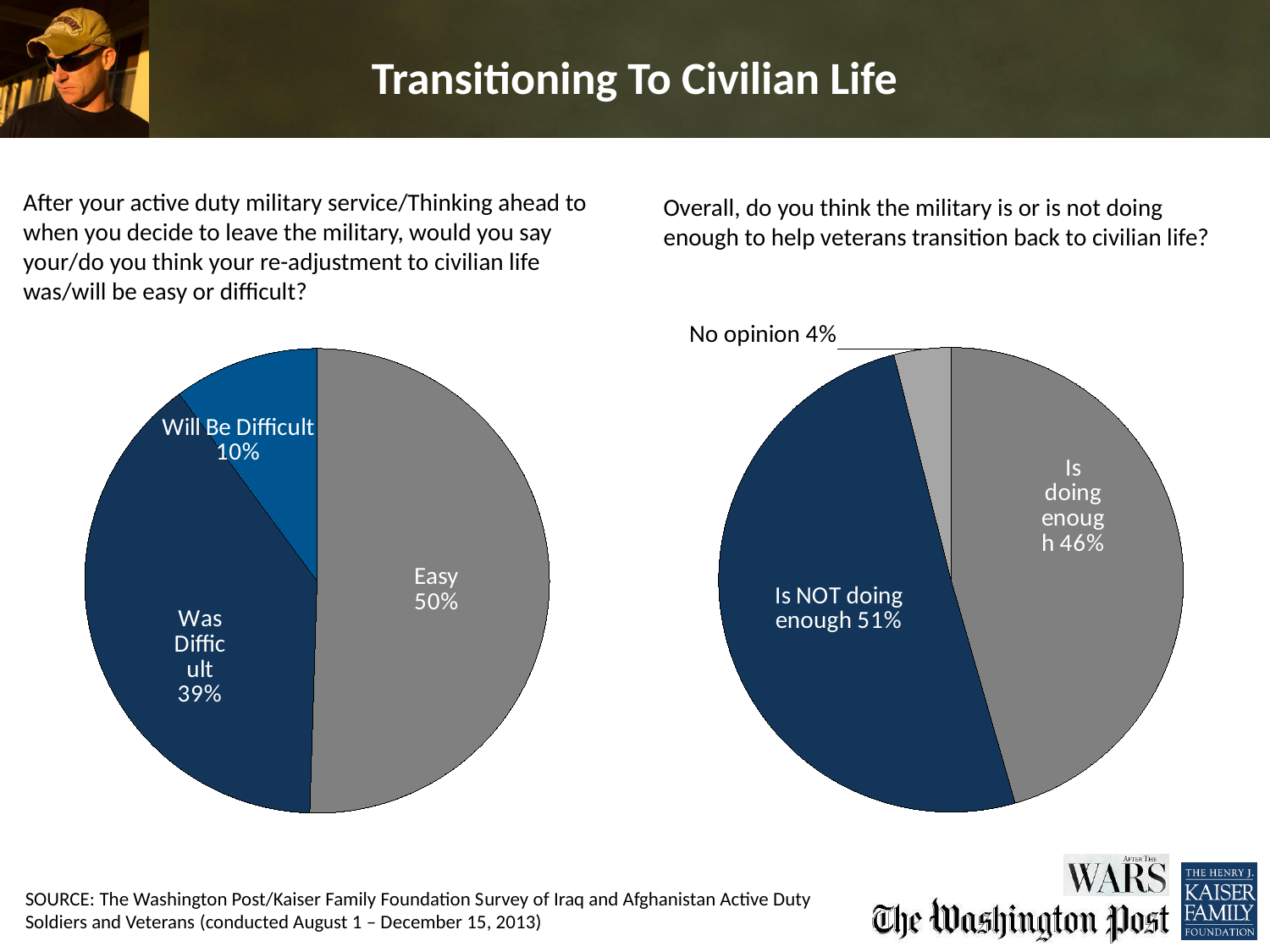
In the left pie chart, what share of respondents said their re-adjustment to civilian life was or will be easy? 50% How many slices does the left pie chart have? 3 In the right pie chart, which is larger: 'Is doing enough' or 'Is NOT doing enough'? Is NOT doing enough In the left pie chart, what percentage is shown for 'Will Be Difficult'? 10% In the left pie chart, what is the difference between the 'Easy' and 'Was Difficult' shares? 11 percentage points In the right pie chart, what is the difference between 'Is NOT doing enough' and 'Is doing enough'? 5 percentage points What type of charts are shown on the slide? Pie charts In the left pie chart, what percentage is shown for 'Was Difficult'? 39% In the right pie chart, what percentage said the military is NOT doing enough to help veterans transition? 51% In the left pie chart, which slice is the smallest? Will Be Difficult In the right pie chart, what share had no opinion? 4% In the right pie chart, what percentage said the military is doing enough? 46%